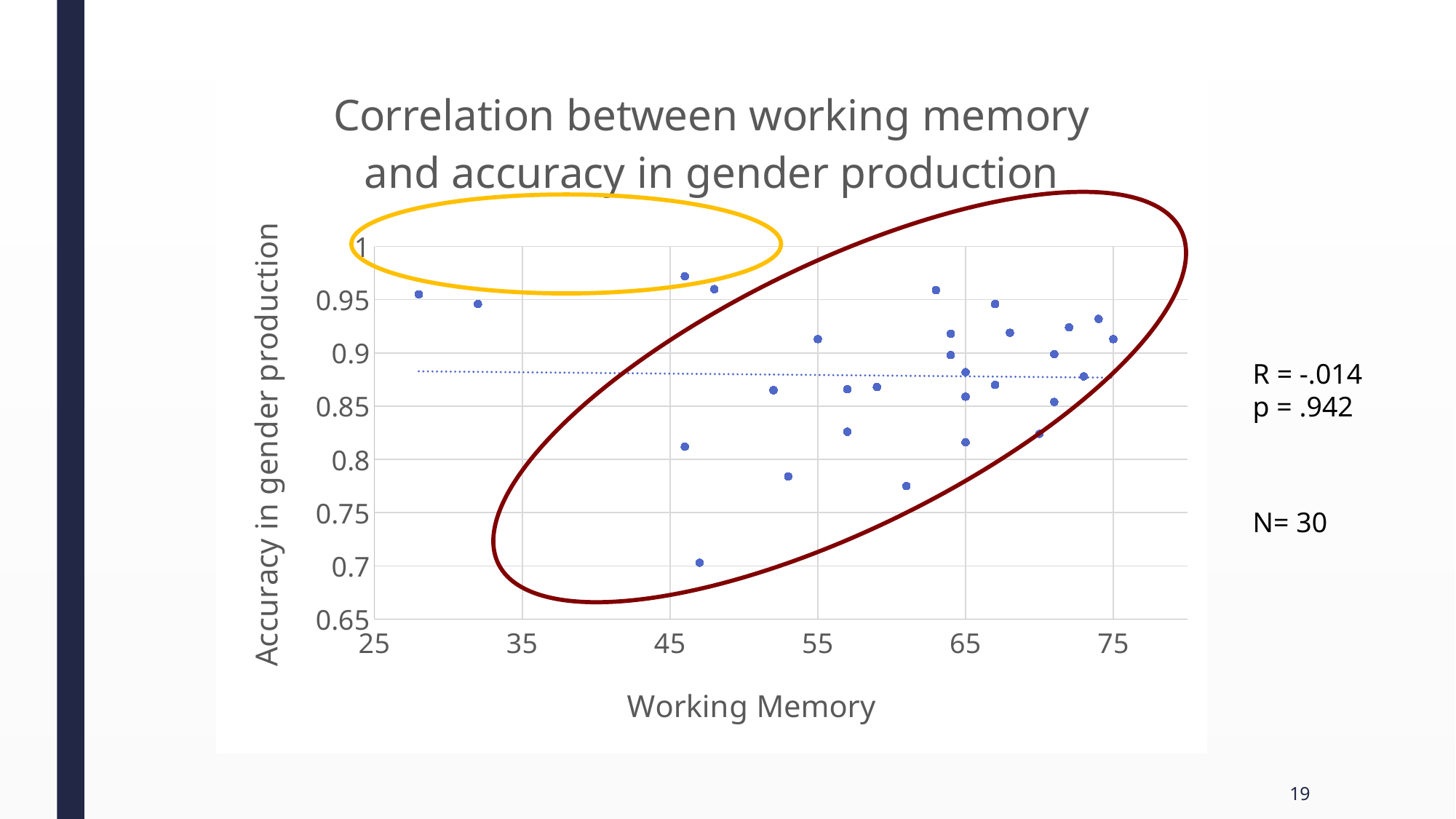
What is the lowest value shown on the y axis? 0.65 Does the dotted trend line rise or fall noticeably as working memory increases along the x axis? It is nearly flat What is the title of the chart? Correlation between working memory and accuracy in gender production Is the working memory value of the lowest-accuracy point greater or less than 55? less What p value is reported on the slide? .942 What is the label of the x axis? Working Memory What kind of chart is shown on the slide? Scatter plot Is the accuracy of the lowest data point greater or less than 0.75? less What sample size N is stated on the slide? 30 What is the correlation coefficient R reported on the slide? -.014 Is the accuracy of the highest data point greater or less than 0.95? greater